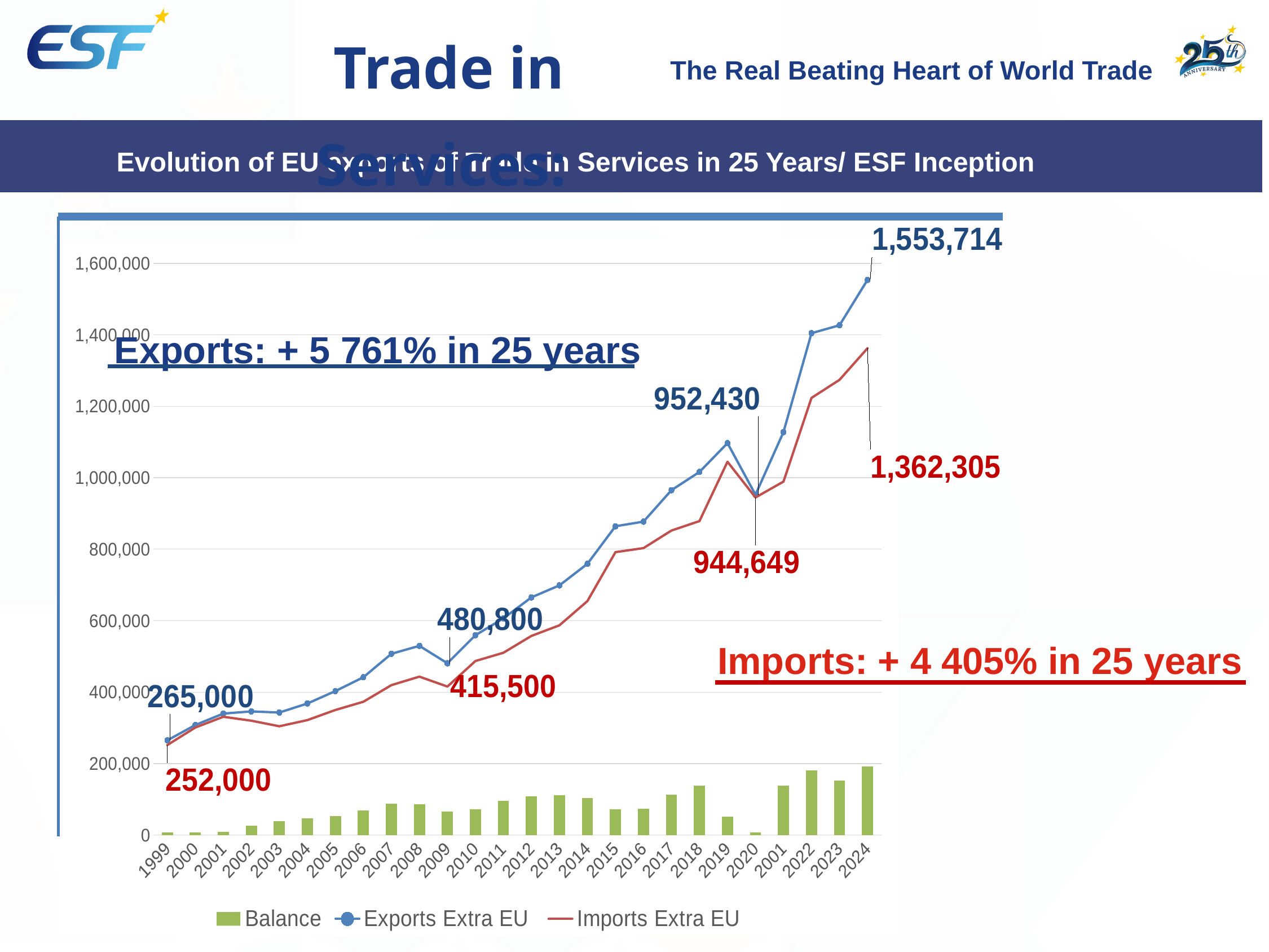
How many series does the legend list? 3 What is the value of Imports Extra EU in 2024? 1,362,305 Which series is shown as green bars in the chart? Balance In 2024, which is larger: Exports Extra EU or Imports Extra EU? Exports Extra EU What is the difference between Exports Extra EU and Imports Extra EU in 1999? 13,000 What is the value of Exports Extra EU in 2009? 480,800 What is the difference between Exports Extra EU and Imports Extra EU in 2024? 191,409 What is the value of Exports Extra EU in 1999? 265,000 What is the value of Imports Extra EU in 2020? 944,649 In which year is Exports Extra EU at its highest? 2024 What is the overall trend of Exports Extra EU from 1999 to 2024? Rising Is the value of Exports Extra EU in 2015 greater or less than 800,000? greater